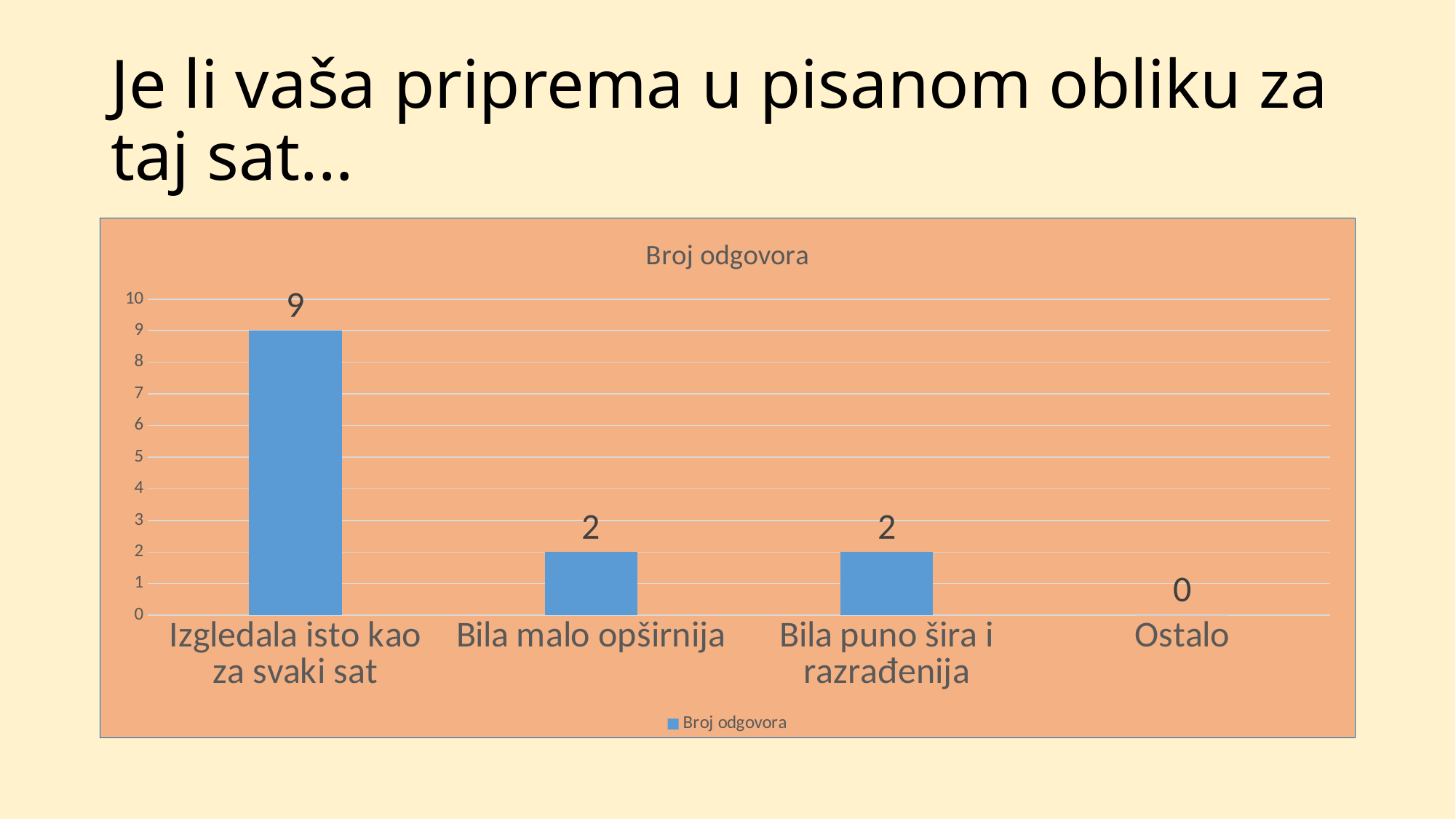
Which category has the lowest value? Ostalo What is the title of the chart? Broj odgovora What is the value for "Bila malo opširnija"? 2 Which is larger: the value for "Bila malo opširnija" or the value for "Ostalo"? Bila malo opširnija What kind of chart is shown on the slide? bar chart Which category has the highest value? Izgledala isto kao za svaki sat Is the value for "Izgledala isto kao za svaki sat" greater or less than 5? greater What is the value for "Izgledala isto kao za svaki sat"? 9 What is the value for "Ostalo"? 0 What is the difference between the values for "Izgledala isto kao za svaki sat" and "Bila puno šira i razrađenija"? 7 How many categories are shown on the x axis? 4 How many series does the legend list? 1